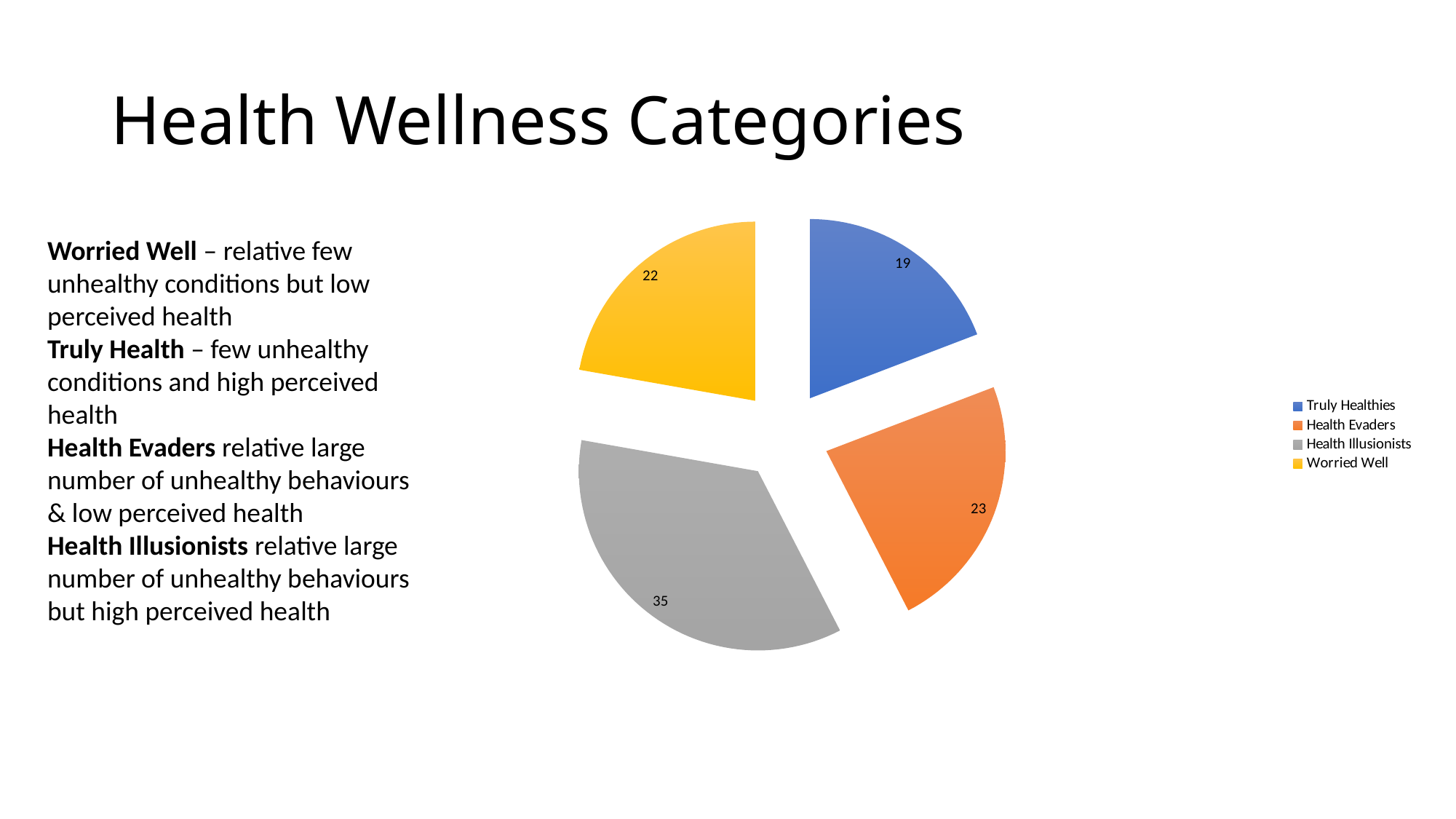
What value is shown for the Truly Healthies slice? 19 What value is shown for the Health Illusionists slice? 35 What kind of chart is shown on the slide? Pie chart What value is shown for the Health Evaders slice? 23 Which category has the smallest slice of the pie? Truly Healthies What colour is the Worried Well slice in the pie chart? Yellow How many categories does the pie chart show? 4 Which category has the largest slice of the pie? Health Illusionists Which is larger, the Health Illusionists slice or the Health Evaders slice? Health Illusionists What value is shown for the Worried Well slice? 22 What is the difference between the Health Evaders value and the Worried Well value? 1 What is the difference between the Health Illusionists value and the Truly Healthies value? 16